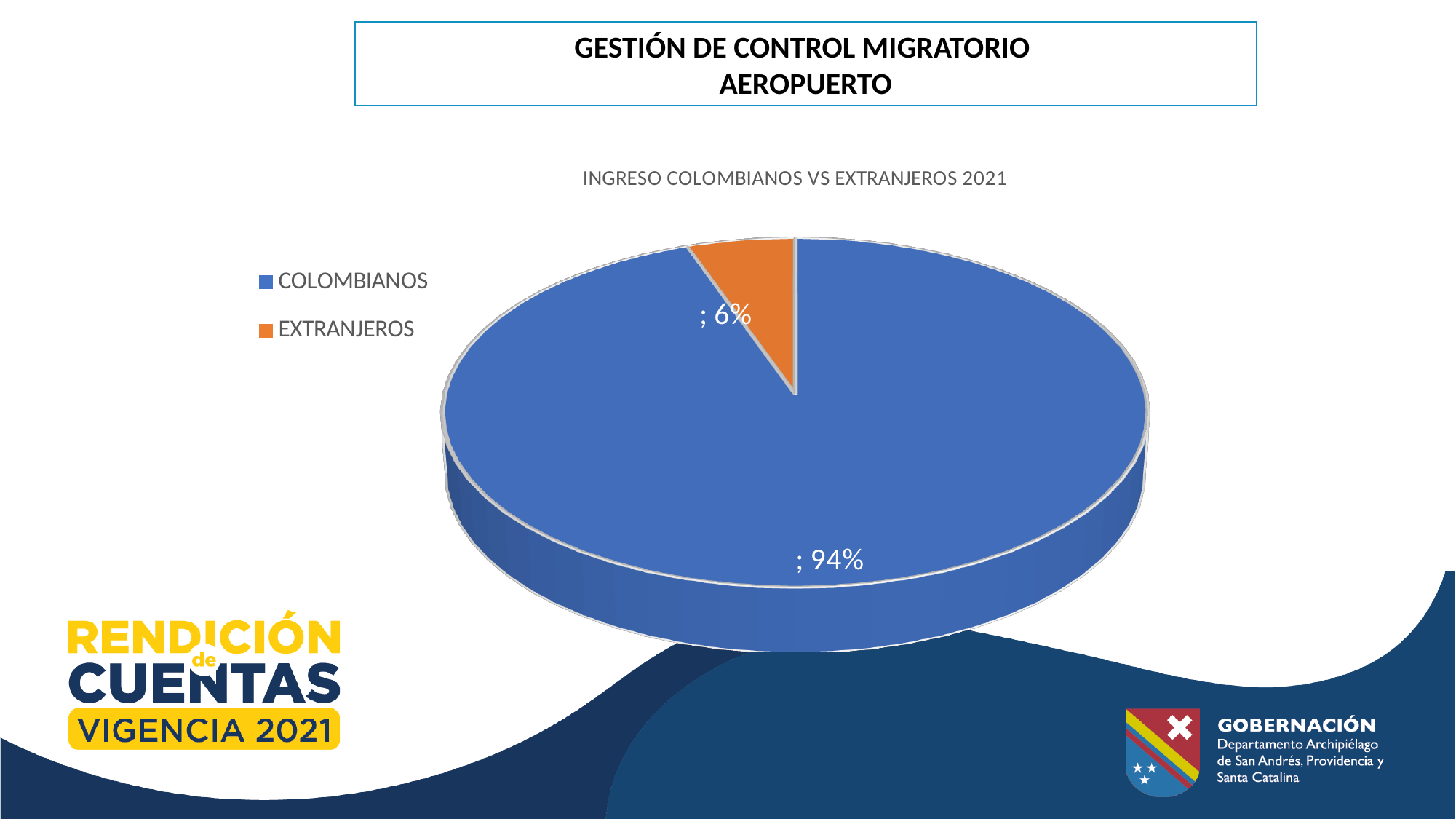
What share of the pie does COLOMBIANOS represent? 94% What is the title of the chart? INGRESO COLOMBIANOS VS EXTRANJEROS 2021 What is the difference in percentage points between the COLOMBIANOS and EXTRANJEROS slices? 88 What kind of chart is shown on the slide? pie chart Which category has the smallest slice of the pie? EXTRANJEROS How many categories does the pie chart show? 2 How many entries does the legend list? 2 What share of the pie does EXTRANJEROS represent? 6% What colour is the EXTRANJEROS slice? orange Which is larger, the COLOMBIANOS slice or the EXTRANJEROS slice? COLOMBIANOS Which category has the largest slice of the pie? COLOMBIANOS